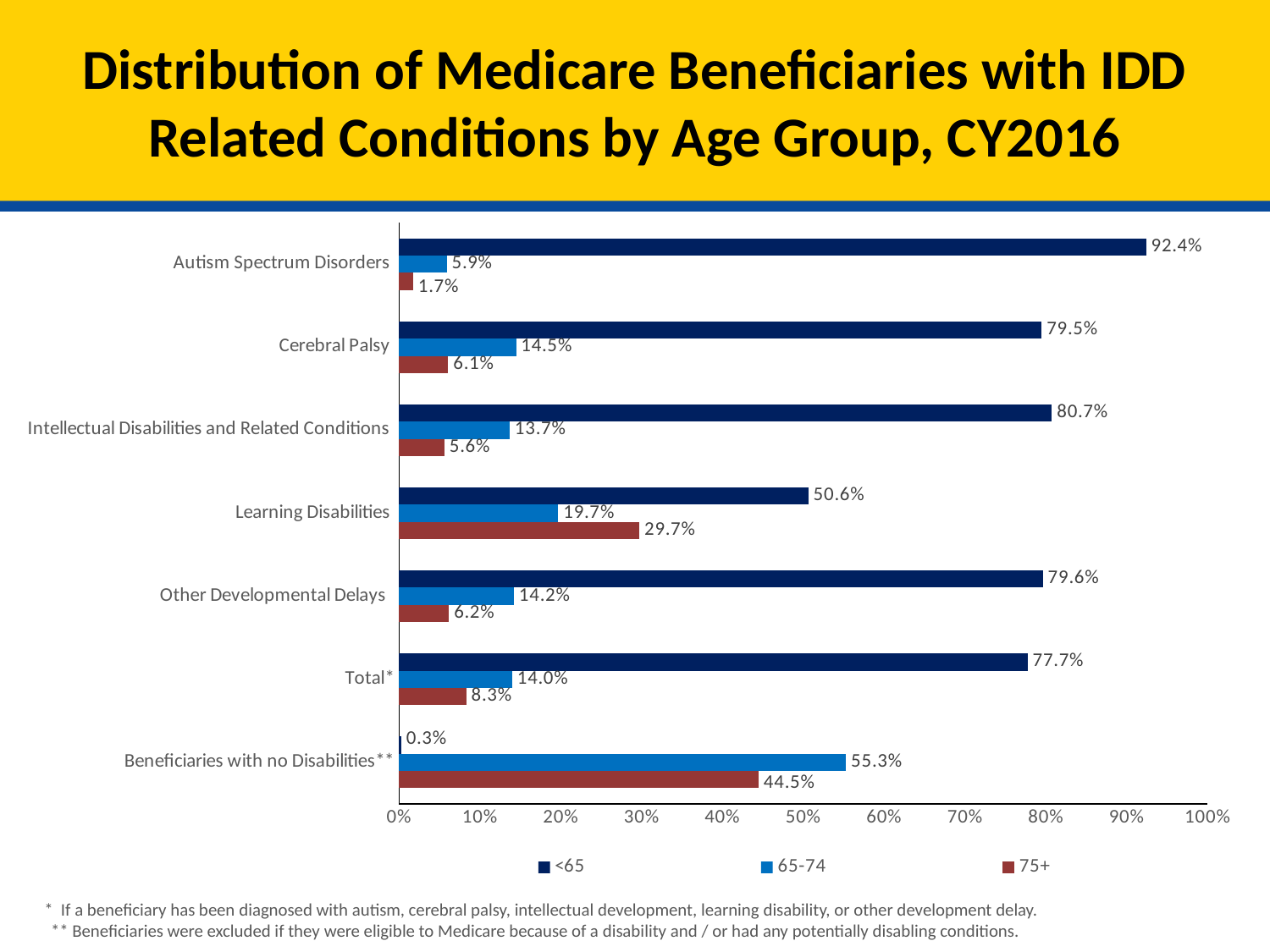
What is the value for the 65-74 series for Beneficiaries with no Disabilities**? 55.3% What kind of chart is shown on the slide? Bar chart Which category has the lowest value in the 75+ series? Autism Spectrum Disorders How many series does the legend list? 3 What is the difference between the <65 value and the 65-74 value for Cerebral Palsy? 65.0% Which is larger for Learning Disabilities: the 65-74 value or the 75+ value? 75+ What is the value for the 75+ series for Learning Disabilities? 29.7% What is the value for the 65-74 series for Total*? 14.0% How many categories are shown on the y axis? 7 Which category has the highest value in the <65 series? Autism Spectrum Disorders What is the value for the <65 series for Autism Spectrum Disorders? 92.4% Is the <65 value for Learning Disabilities greater or less than 40%? greater